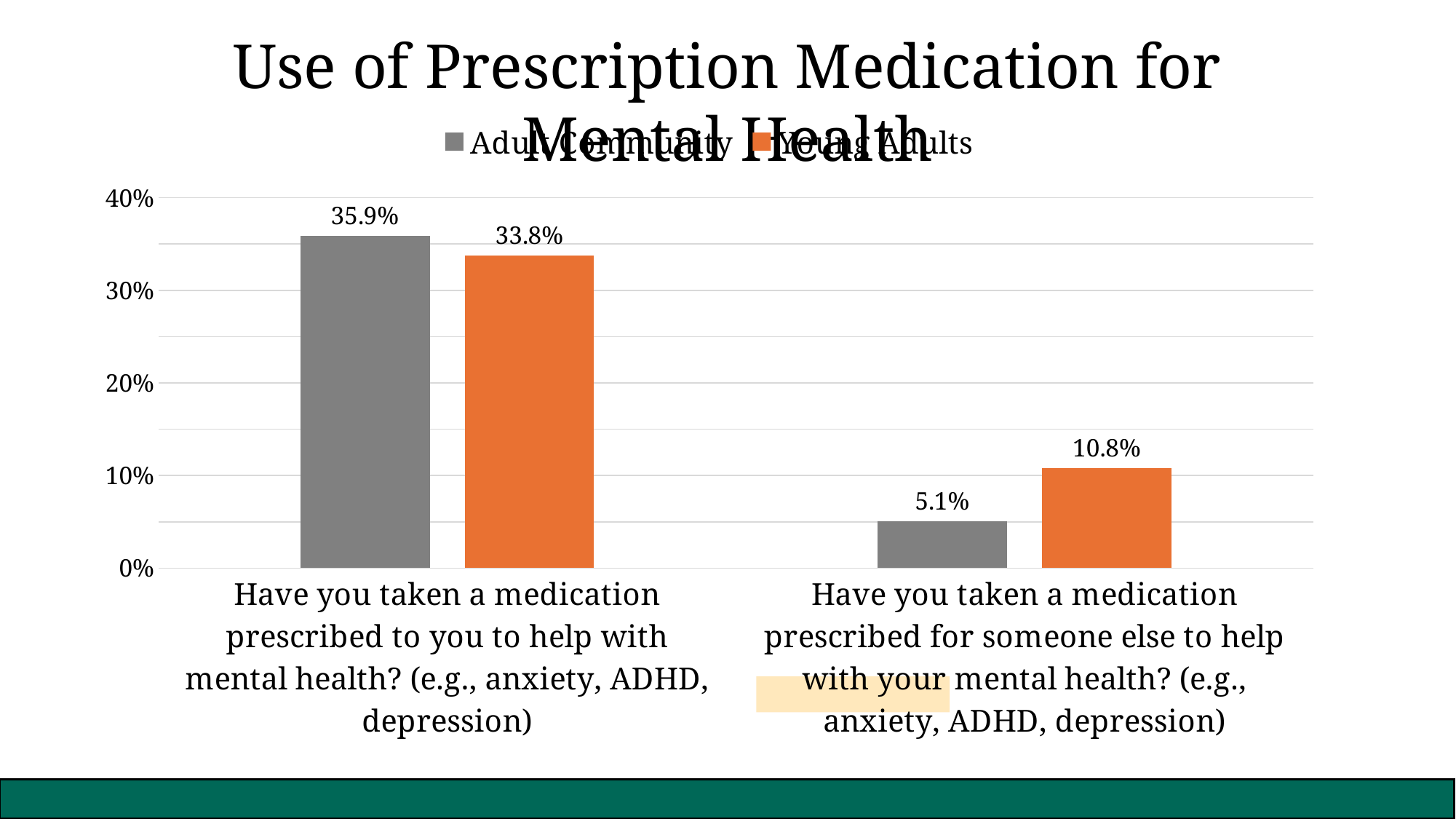
What percentage of the Adult Community reported taking a medication prescribed for someone else to help with their mental health? 5.1% Which group has the higher value for taking a medication prescribed for someone else, Adult Community or Young Adults? Young Adults What is the difference between the Young Adults and Adult Community values for taking a medication prescribed for someone else? 5.7% Is the Young Adults value for taking a medication prescribed for someone else greater or less than 10%? greater What percentage of Young Adults reported taking a medication prescribed for someone else to help with their mental health? 10.8% Which group has the higher value for taking a medication prescribed to them, Adult Community or Young Adults? Adult Community How many series does the legend list? 2 What type of chart is shown on the slide? Bar chart What percentage of Young Adults reported taking a medication prescribed to them to help with mental health? 33.8% What is the difference between the Adult Community and Young Adults values for taking a medication prescribed to them? 2.1% Which bar in the chart has the lowest value? Adult Community, medication prescribed for someone else (5.1%) What percentage of the Adult Community reported taking a medication prescribed to them to help with mental health? 35.9%